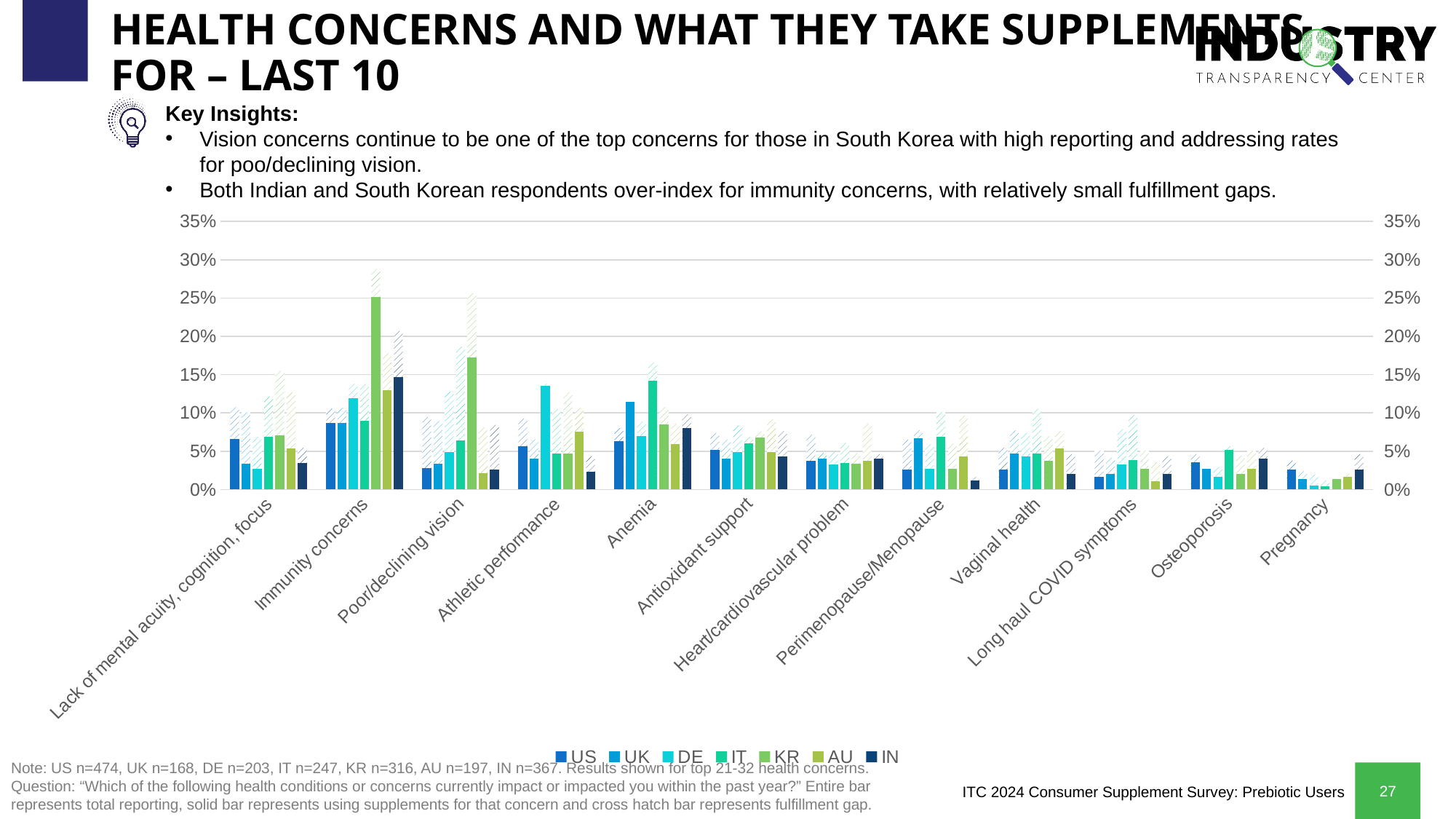
Which series has the tallest solid bar for Anemia? IT Which series has the tallest solid bar for Immunity concerns? KR Is the solid KR bar for Immunity concerns greater or less than 20%? greater Is the solid IN bar for Immunity concerns greater or less than 10%? greater How many series does the legend list? 7 For Immunity concerns, which solid bar is taller, KR or IN? KR What kind of chart is shown on the slide? bar chart Is the solid KR bar for Poor/declining vision greater or less than 15%? greater Which series has the tallest solid bar for Athletic performance? DE What is the highest value shown on the vertical axis? 35% For Anemia, which solid bar is taller, US or IT? IT How many health concern categories are shown on the x axis? 12